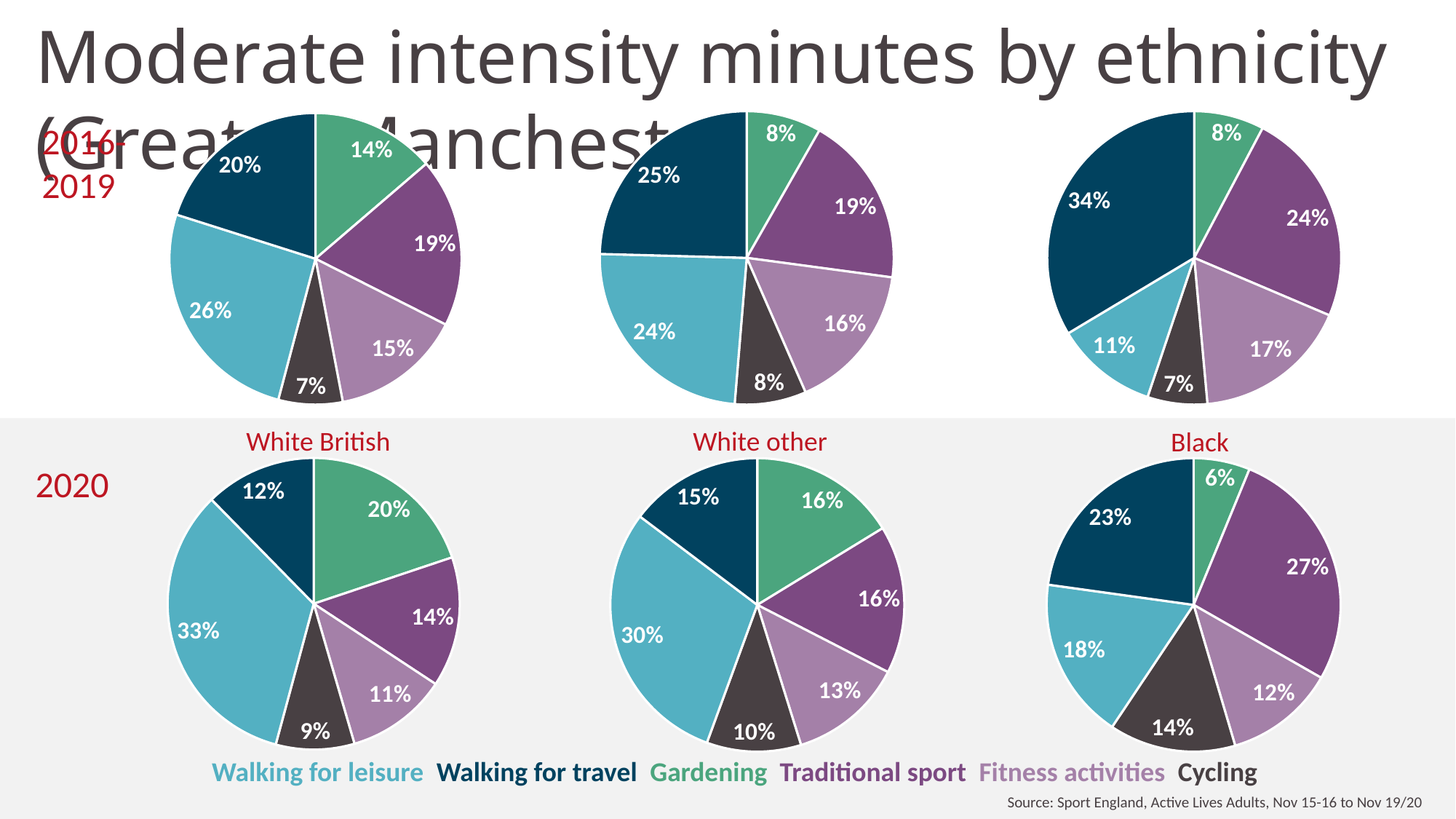
What type of charts are shown on the slide? Pie charts In the 2020 Black pie chart, which activity has the smallest share? Gardening How many slices does each pie chart on the slide have? 6 In the 2016-2019 Black pie chart, which is larger: Traditional sport or Fitness activities? Traditional sport In the 2016-2019 Black pie chart, what share is Walking for travel? 34% How many activities does the legend list? 6 In the 2020 White British pie chart, what is the difference between the Walking for leisure share and the Walking for travel share? 21% In the 2016-2019 White British pie chart, which activity has the smallest share? Cycling In the 2016-2019 White other pie chart, what share is Fitness activities? 16% In the 2020 White British pie chart, what share is Walking for leisure? 33% In the 2020 Black pie chart, what share is Traditional sport? 27% In the 2020 White other pie chart, which activity has the largest share? Walking for leisure